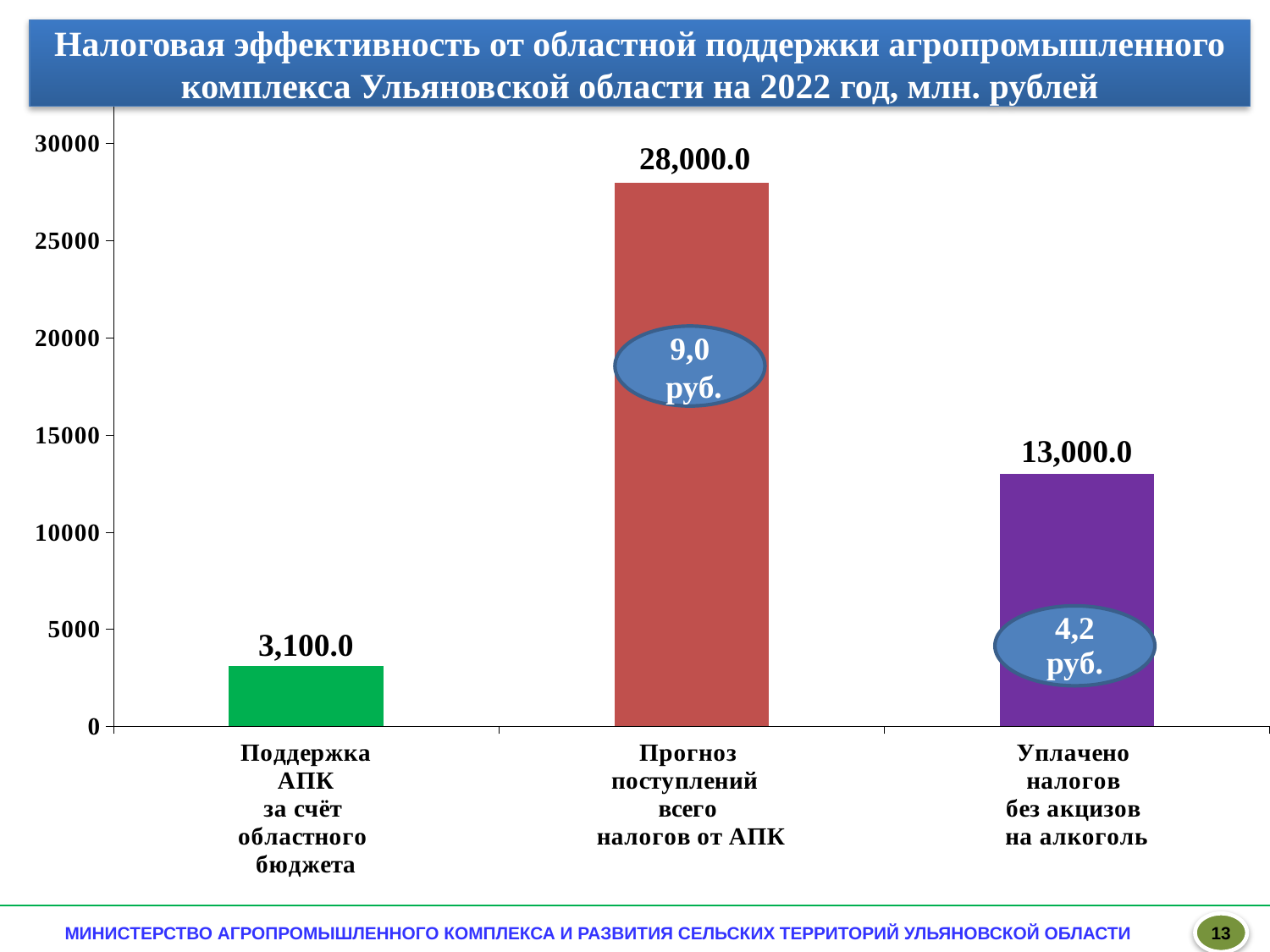
What is the difference between the values for "Прогноз поступлений всего налогов от АПК" and "Уплачено налогов без акцизов на алкоголь"? 15,000.0 How many categories are shown in the chart? 3 What kind of chart is shown on the slide? bar chart Is the value for "Уплачено налогов без акцизов на алкоголь" greater or less than 15000? less What is the value for "Прогноз поступлений всего налогов от АПК"? 28,000.0 What is the difference between the values for "Уплачено налогов без акцизов на алкоголь" and "Поддержка АПК за счёт областного бюджета"? 9,900.0 What is the value for "Уплачено налогов без акцизов на алкоголь"? 13,000.0 Which is larger: the value for "Уплачено налогов без акцизов на алкоголь" or the value for "Поддержка АПК за счёт областного бюджета"? Уплачено налогов без акцизов на алкоголь Which category has the lowest value? Поддержка АПК за счёт областного бюджета What label is shown in the oval on the bar for "Прогноз поступлений всего налогов от АПК"? 9,0 руб. Which category has the highest value? Прогноз поступлений всего налогов от АПК What is the value for "Поддержка АПК за счёт областного бюджета"? 3,100.0